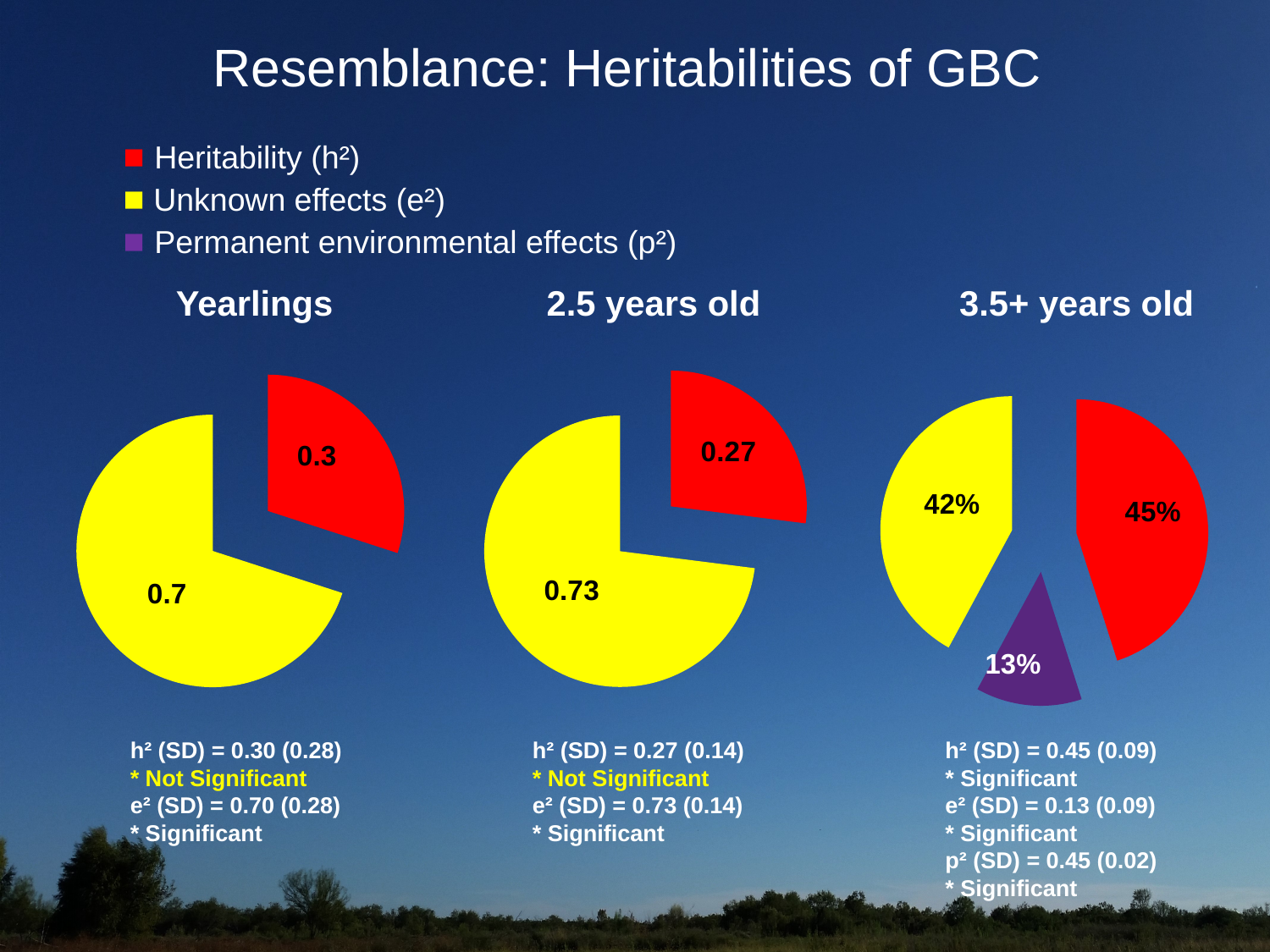
In the 3.5+ years old pie chart, which slice is the smallest? Permanent environmental effects (p²) In the 2.5 years old pie chart, what is the difference between the Unknown effects (e²) value and the Heritability (h²) value? 0.46 How many series does the legend list? 3 In the Yearlings pie chart, what is the value of the yellow Unknown effects (e²) slice? 0.7 How many pie charts are on the slide? 3 In the 2.5 years old pie chart, what is the value of the Heritability (h²) slice? 0.27 What kind of charts are shown on the slide? Pie charts In the 3.5+ years old pie chart, what share is labelled on the red Heritability (h²) slice? 45% In the Yearlings pie chart, which slice is larger, Heritability (h²) or Unknown effects (e²)? Unknown effects (e²) In the 2.5 years old pie chart, what is the value of the Unknown effects (e²) slice? 0.73 In the Yearlings pie chart, what is the value of the red Heritability (h²) slice? 0.3 In the 3.5+ years old pie chart, what share is labelled on the purple Permanent environmental effects (p²) slice? 13%